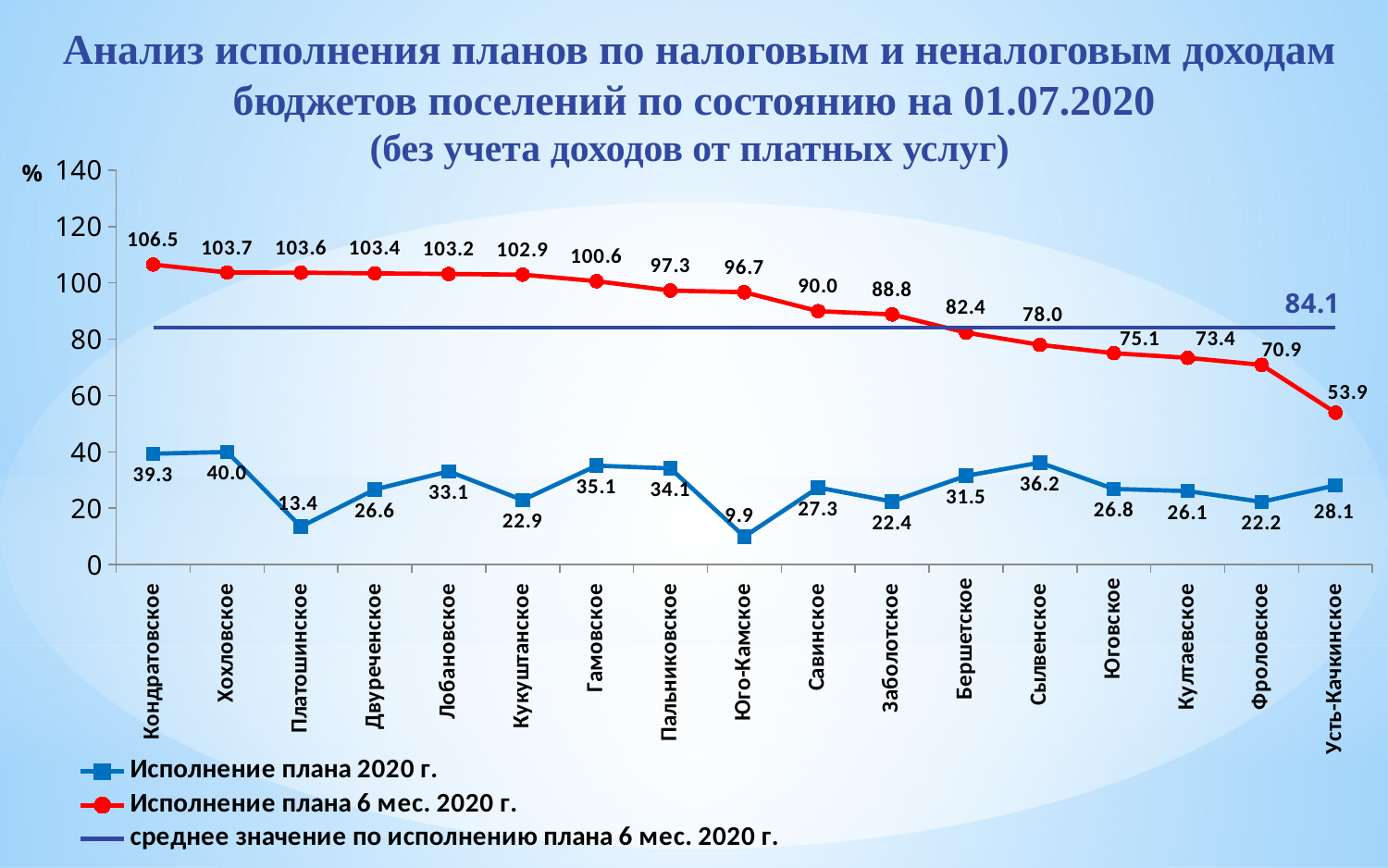
How many settlements are shown on the x axis? 17 What is the value of the average line 'среднее значение по исполнению плана 6 мес. 2020 г.'? 84.1 How many entries does the legend list? 3 What is the value of 'Исполнение плана 6 мес. 2020 г.' for Кондратовское? 106.5 What is the value of 'Исполнение плана 6 мес. 2020 г.' for Усть-Качкинское? 53.9 What kind of chart is shown on the slide? line chart Which settlement has the highest value for 'Исполнение плана 2020 г.'? Хохловское Does the 'Исполнение плана 6 мес. 2020 г.' line rise or fall from left to right? fall Which settlement has the lowest value for 'Исполнение плана 6 мес. 2020 г.'? Усть-Качкинское What is the difference between the 'Исполнение плана 6 мес. 2020 г.' values for Кондратовское and Усть-Качкинское? 52.6 Which is larger for Сылвенское: 'Исполнение плана 2020 г.' or 'Исполнение плана 6 мес. 2020 г.'? Исполнение плана 6 мес. 2020 г. What is the value of 'Исполнение плана 2020 г.' for Юго-Камское? 9.9